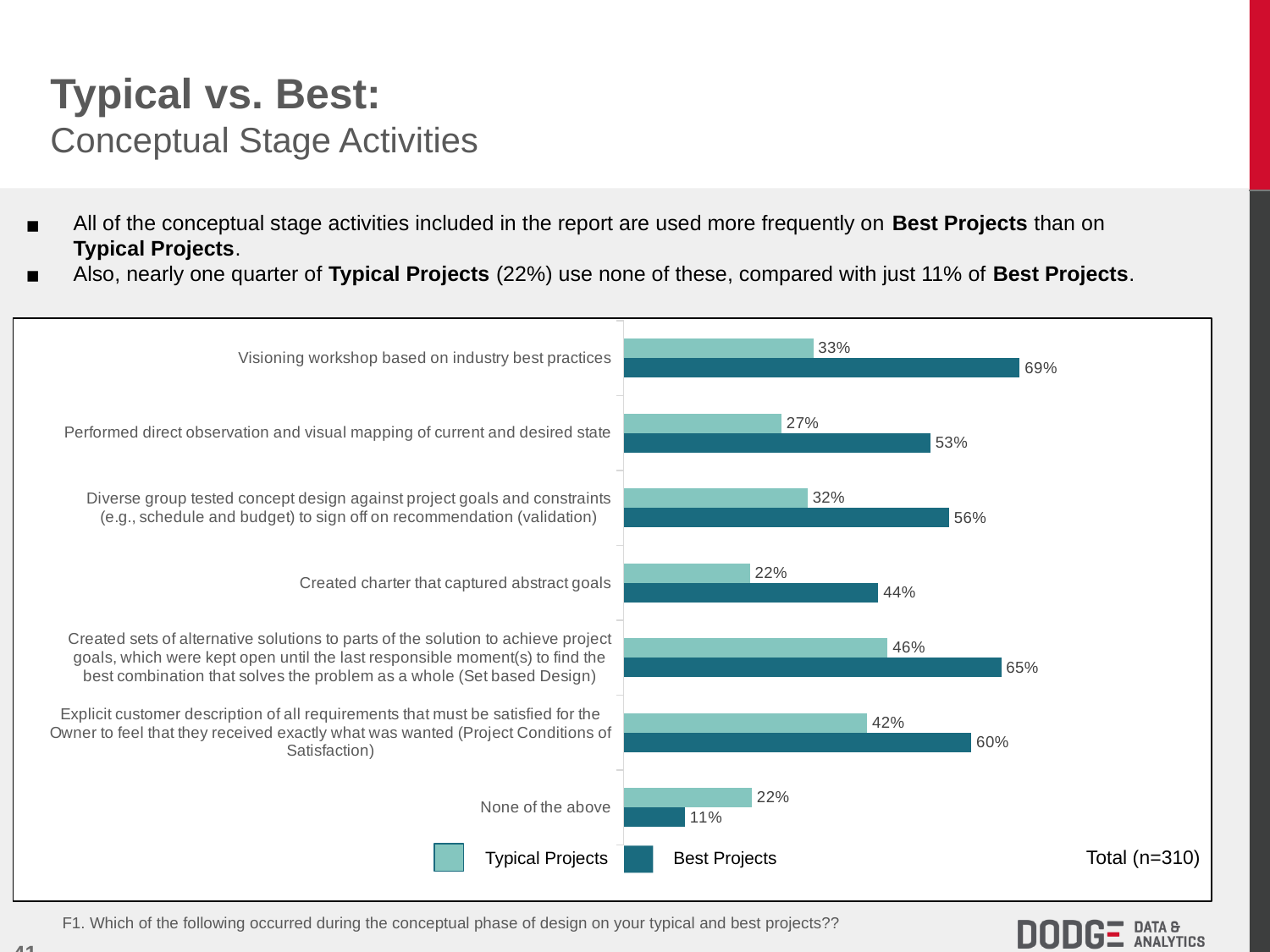
What sample size is noted in the chart? Total (n=310) What is the Typical Projects value for the "Set based Design" category (Created sets of alternative solutions...)? 46% Which category has the highest Best Projects value? Visioning workshop based on industry best practices What is the Best Projects value for "Visioning workshop based on industry best practices"? 69% How many series does the legend list? 2 What is the Typical Projects value for "Created charter that captured abstract goals"? 22% What is the difference between the Best Projects and Typical Projects values for "Performed direct observation and visual mapping of current and desired state"? 26% What is the Best Projects value for "None of the above"? 11% How many categories are shown in the chart? 7 Which category has the lowest Best Projects value? None of the above What kind of chart is shown on the slide? Bar chart For "None of the above", which is larger: the Typical Projects value or the Best Projects value? Typical Projects